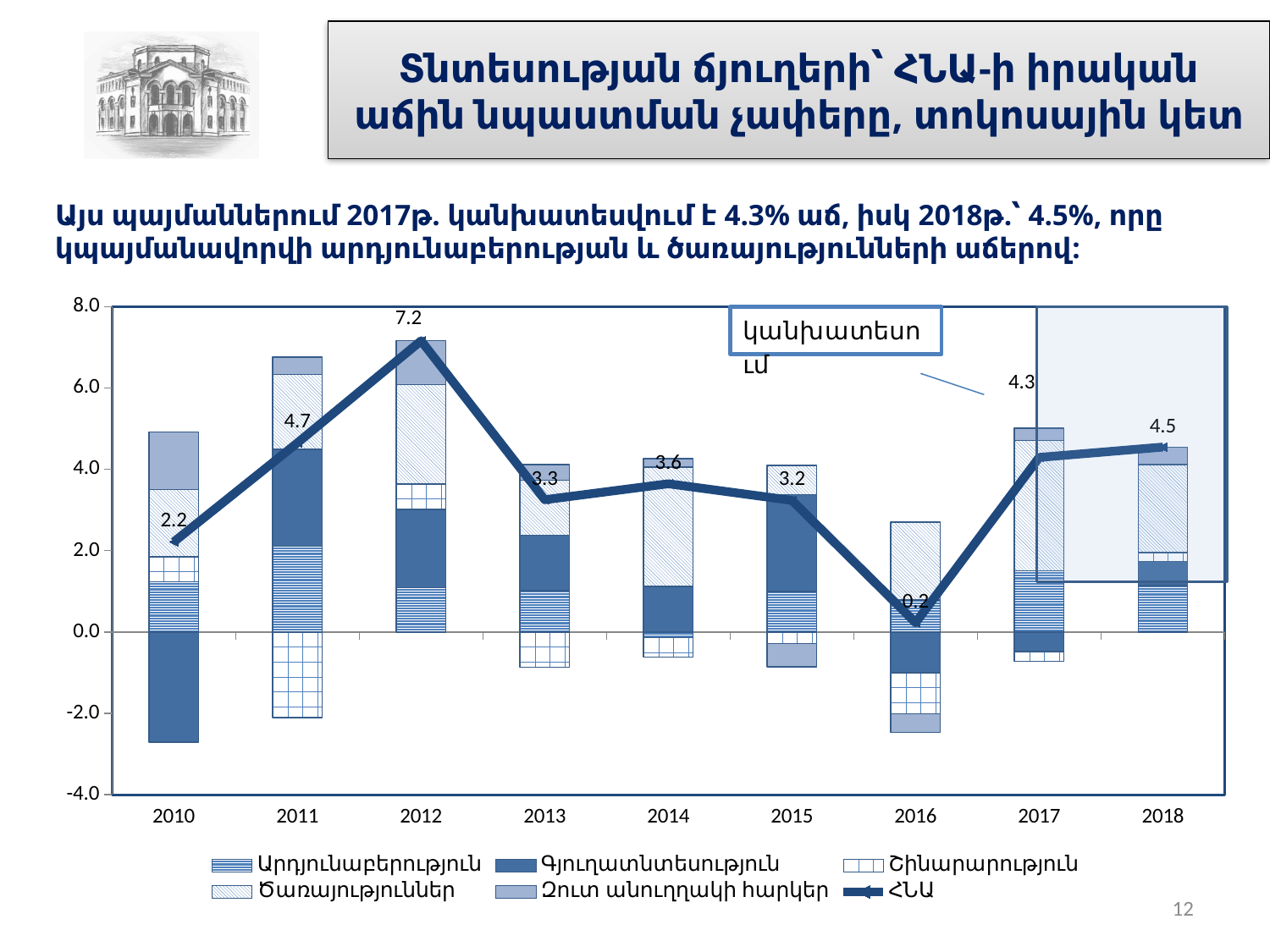
Does the ՀՆԱ line rise or fall from 2012 to 2016? fall Which year has a higher ՀՆԱ value, 2014 or 2015? 2014 What kind of chart is shown on the slide? Stacked bar chart with a line In which year does the ՀՆԱ line reach its highest value? 2012 What is the difference between the ՀՆԱ values for 2012 and 2011? 2.5 What is the value of the ՀՆԱ line for 2018? 4.5 Is the ՀՆԱ value for 2017 greater or less than 4.0? greater In which year does the ՀՆԱ line reach its lowest value? 2016 What is the value of the ՀՆԱ line for 2016? 0.2 How many years are shown on the x axis of the chart? 9 What is the value of the ՀՆԱ line for 2012? 7.2 How many series does the chart legend list? 6